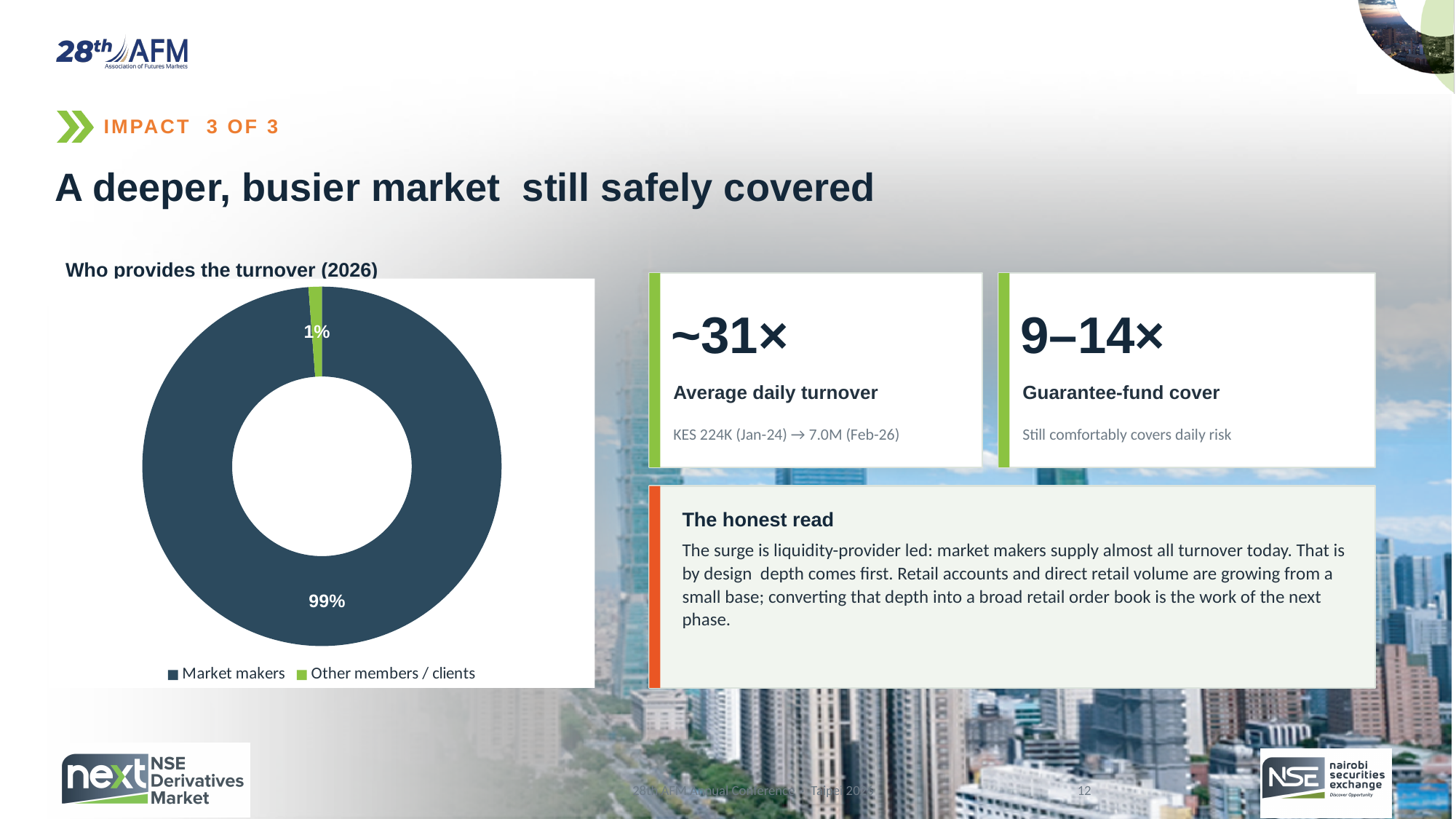
Which category has the smallest share in the 'Who provides the turnover (2026)' chart? Other members / clients Which is larger in the 'Who provides the turnover (2026)' chart: Market makers or Other members / clients? Market makers What share of turnover do Other members / clients provide in the 'Who provides the turnover (2026)' chart? 1% What is the title of the chart on the slide? Who provides the turnover (2026) How many entries does the legend of the 'Who provides the turnover (2026)' chart list? 2 What colour represents Other members / clients in the chart? Green What share of turnover do Market makers provide in the 'Who provides the turnover (2026)' chart? 99% How many categories are shown in the 'Who provides the turnover (2026)' chart? 2 Which category has the largest share in the 'Who provides the turnover (2026)' chart? Market makers What is the difference in percentage points between the Market makers share and the Other members / clients share? 98 percentage points What kind of chart is 'Who provides the turnover (2026)'? Doughnut (pie) chart Is the Market makers share in the chart greater or less than 50%? greater